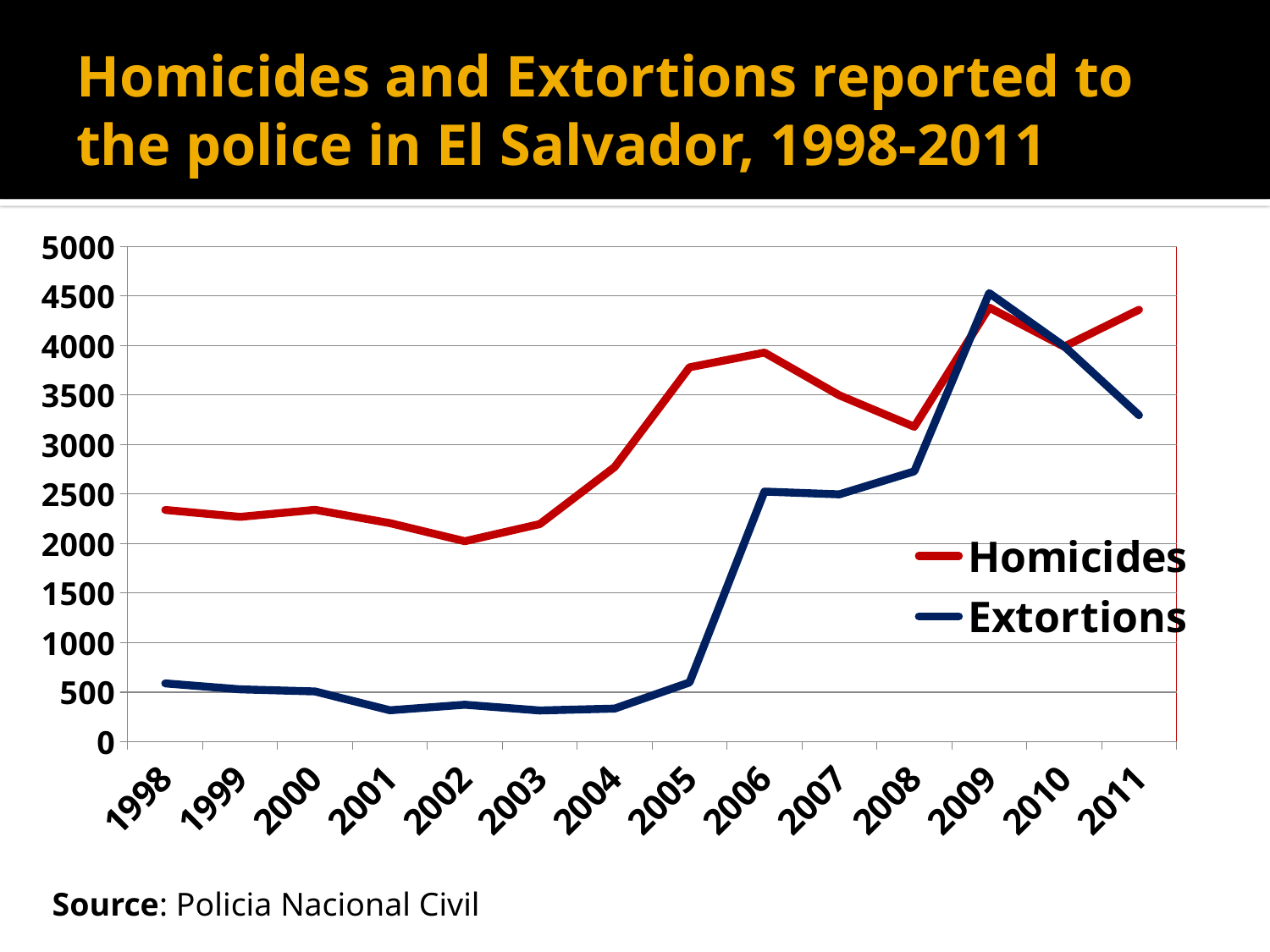
In which year is the Extortions value highest? 2009 In 2011, which series has the larger value, Homicides or Extortions? Homicides Is the Extortions value for 2011 greater or less than 3500? less Do the Extortions values rise or fall from 2005 to 2009? rise Which colour is used for the Extortions line? dark blue Is the Extortions value for 1998 greater or less than 1000? less Is the Extortions value for 2006 greater or less than 2000? greater In which year is the Homicides value lowest? 2002 What kind of chart is shown on the slide? line chart How many years are plotted along the x axis? 14 How many series does the legend list? 2